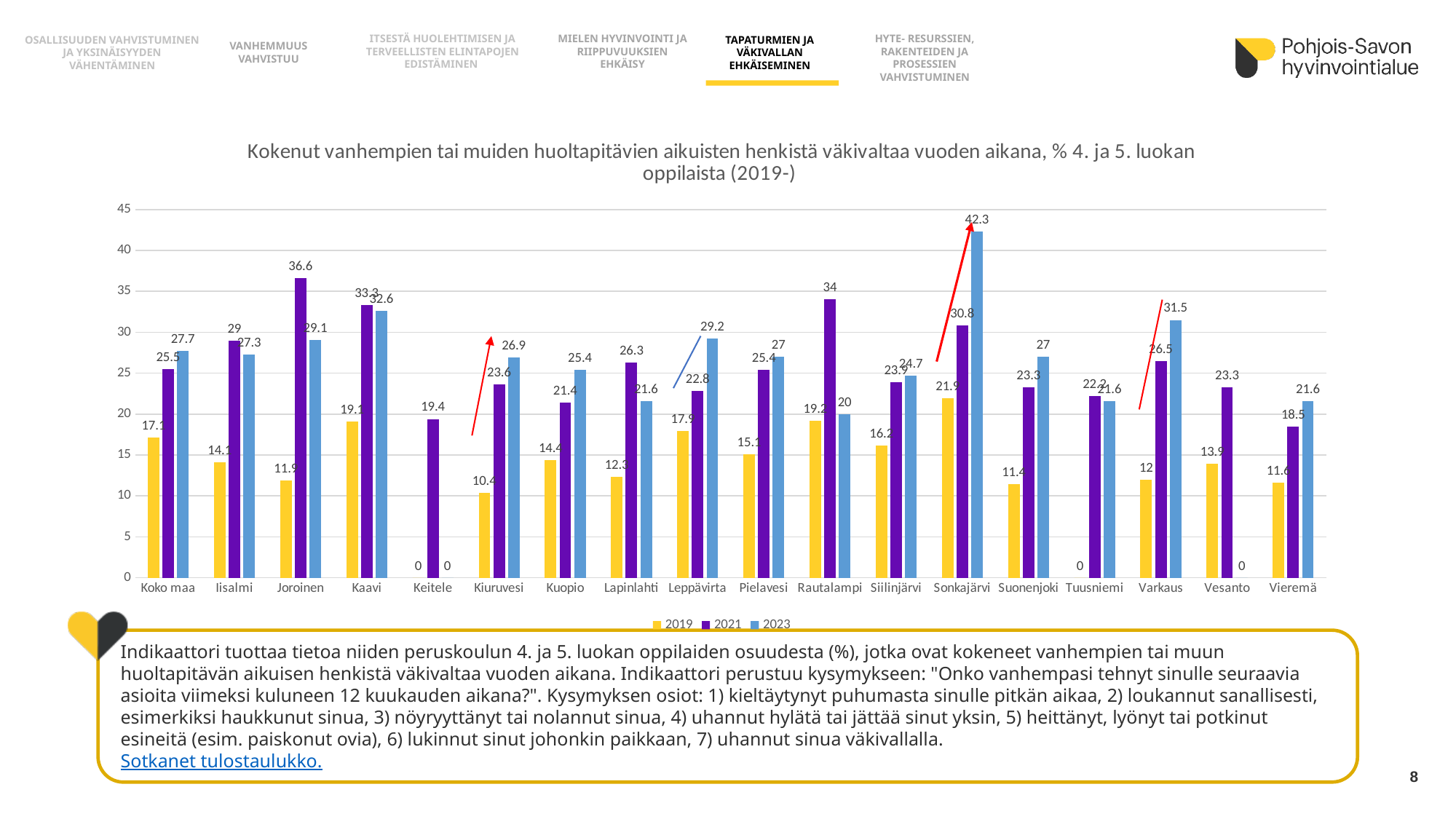
What kind of chart is shown on the slide? bar chart How many series does the legend list? 3 Is the 2019 value for Kiuruvesi greater or less than 15? less Which is larger, the 2021 value for Joroinen or the 2021 value for Kaavi? Joroinen What is the 2023 value for Sonkajärvi? 42.3 Which category has the highest 2023 value? Sonkajärvi What is the 2021 value for Joroinen? 36.6 Do the values for Kuopio rise or fall from 2019 to 2023? rise How many municipalities/categories are shown on the x axis? 18 What is the 2021 value for Rautalampi? 34 What is the difference between the 2023 values for Sonkajärvi and Varkaus? 10.8 What is the 2019 value for Keitele? 0